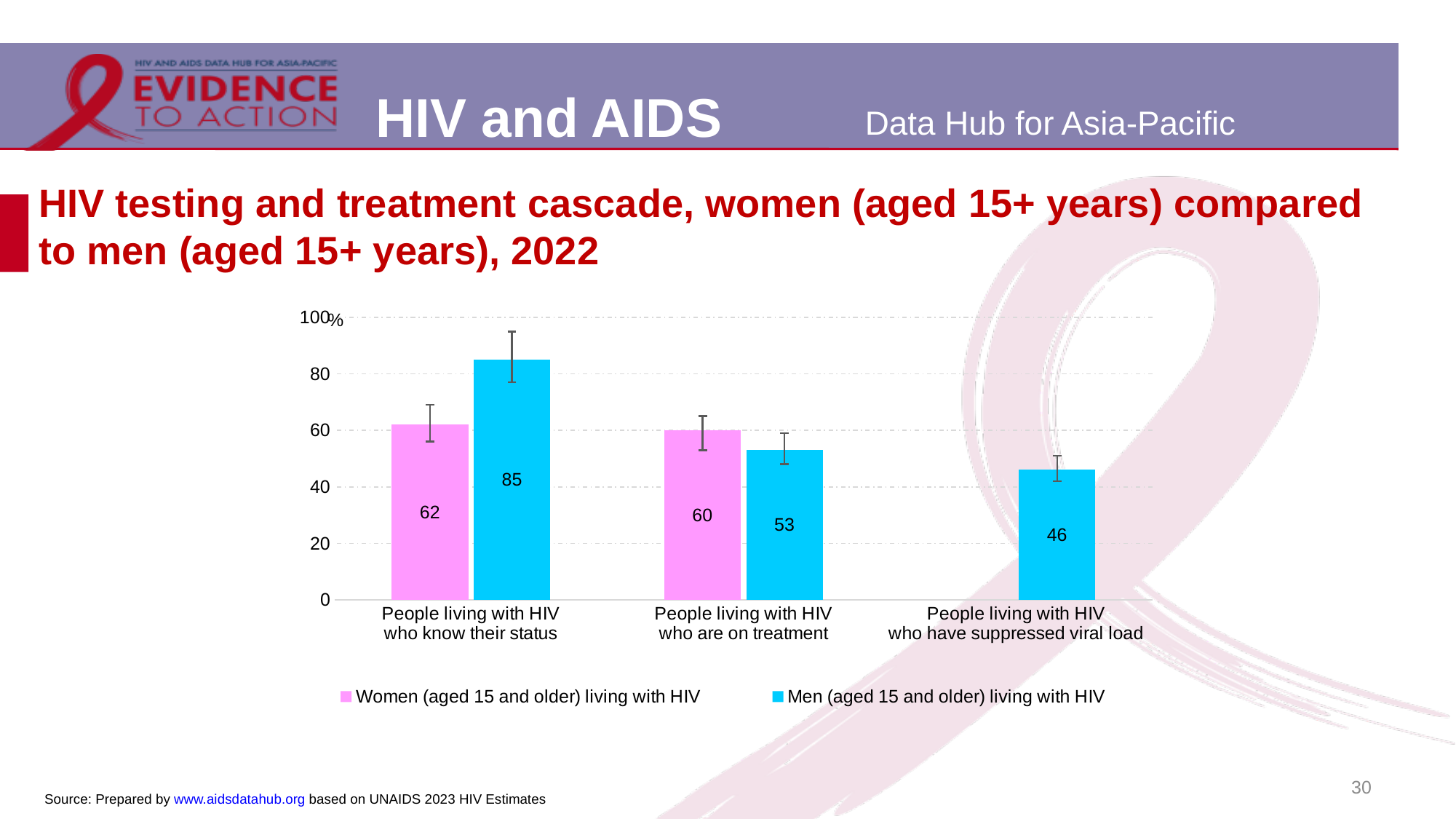
Which category has the highest value for men (aged 15 and older) living with HIV? People living with HIV who know their status What kind of chart is shown on the slide? Bar chart Which category has the lowest value for men (aged 15 and older) living with HIV? People living with HIV who have suppressed viral load What is the value for men (aged 15 and older) living with HIV who have suppressed viral load? 46 For people living with HIV who are on treatment, which is larger: the value for women or the value for men? Women Is the value for men (aged 15 and older) living with HIV who know their status greater or less than 80? greater How many categories are shown on the x axis? 3 What is the difference between the men's and women's values for people living with HIV who know their status? 23 What is the value for women (aged 15 and older) living with HIV who know their status? 62 How many series does the legend list? 2 What is the value for women (aged 15 and older) living with HIV who are on treatment? 60 What is the value for men (aged 15 and older) living with HIV who know their status? 85